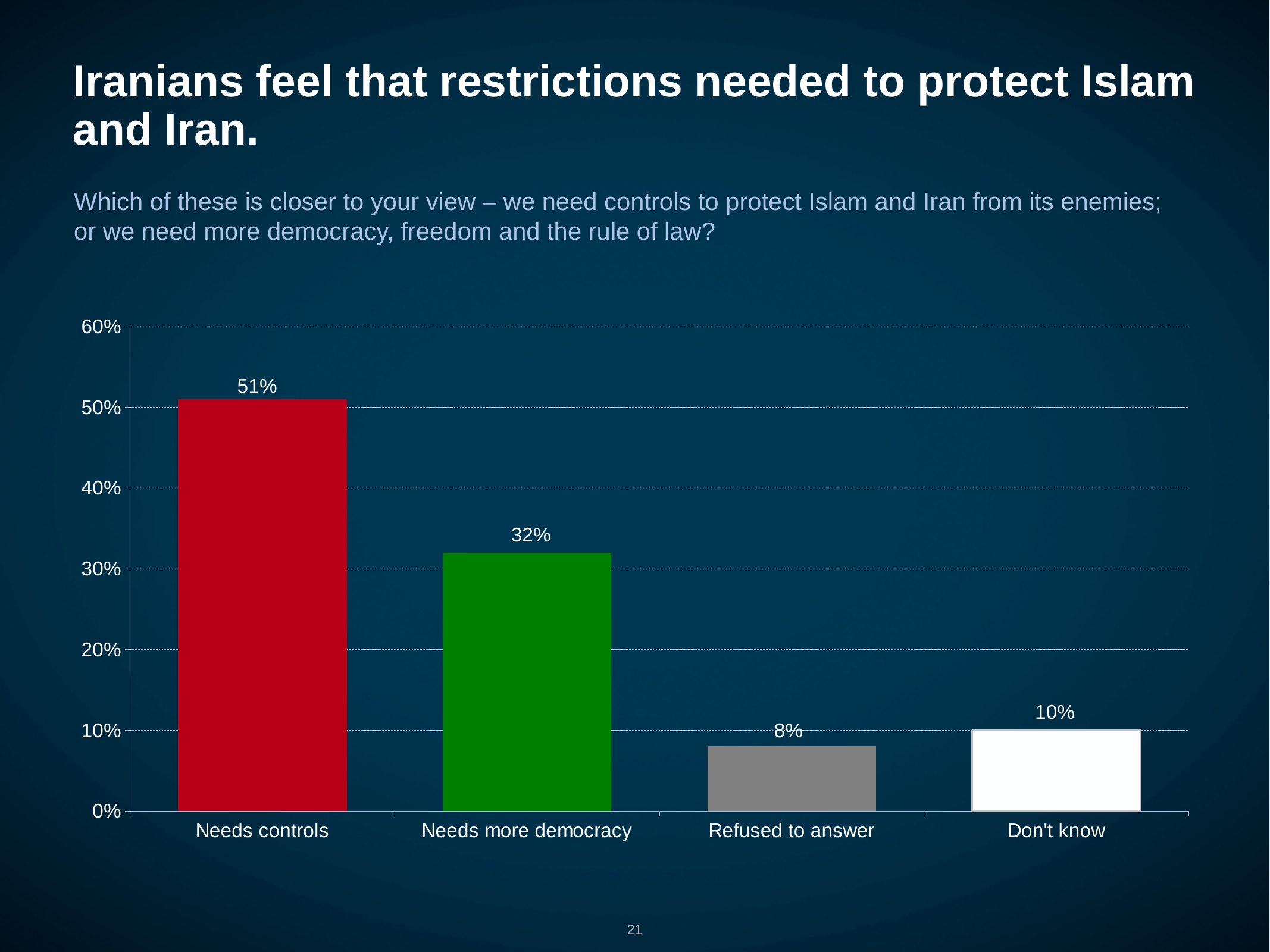
What percentage of respondents said Iran needs controls? 51% What percentage of respondents refused to answer? 8% What is the value shown for Needs more democracy? 32% How many categories are shown on the x axis? 4 Which category has the highest value? Needs controls Is the value for Needs more democracy greater or less than 40%? less What kind of chart is shown on the slide? bar chart Which is larger, Don't know or Refused to answer? Don't know What colour is the bar for Needs more democracy? green What is the value shown for Don't know? 10% Which category has the lowest value? Refused to answer What is the difference between Needs controls and Needs more democracy? 19%